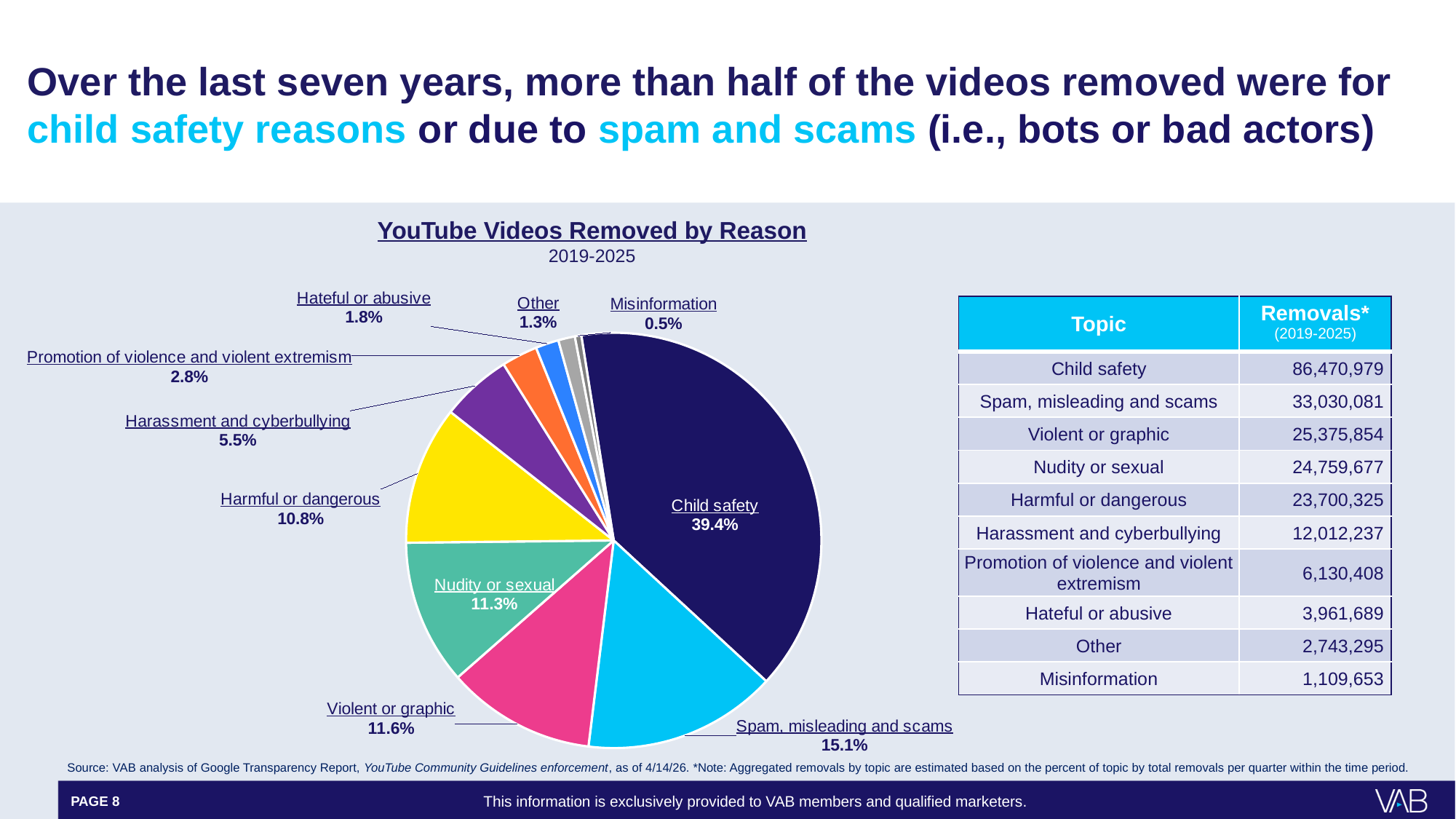
Which is larger, the slice for Violent or graphic or the slice for Nudity or sexual? Violent or graphic What share of the pie does Child safety account for? 39.4% What is the value shown for Harmful or dangerous? 10.8% Which reason has the smallest slice of the pie? Misinformation What kind of chart is shown on the slide? Pie chart What percentage of removed videos were for Spam, misleading and scams? 15.1% What is the title of the chart? YouTube Videos Removed by Reason What time period does the chart cover, according to its subtitle? 2019-2025 What is the combined share of Child safety and Spam, misleading and scams? 54.5% What is the difference in percentage points between Child safety and Spam, misleading and scams? 24.3 Which reason has the largest slice of the pie? Child safety How many slices does the pie chart have? 10